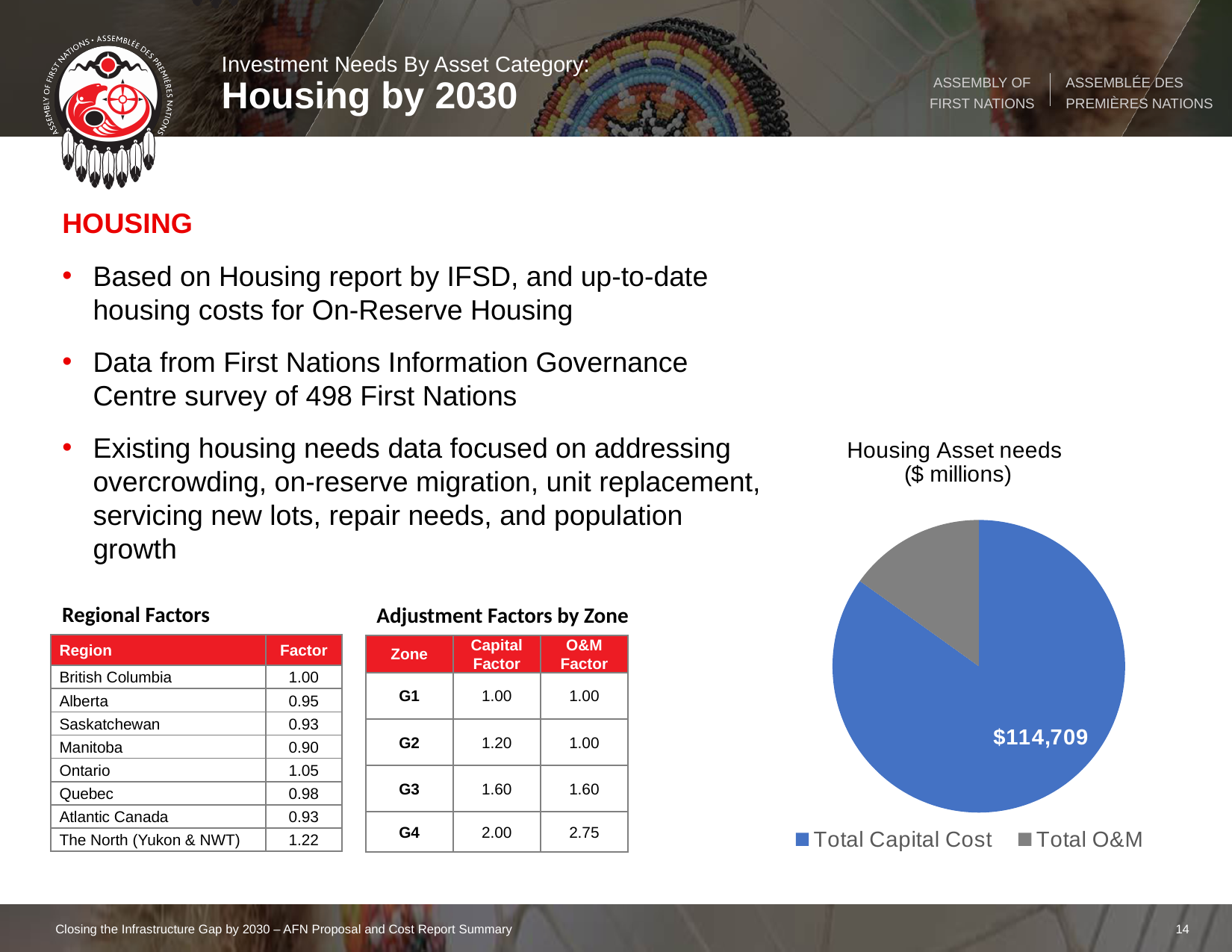
What is the title of the pie chart? Housing Asset needs ($ millions) In the pie chart, which is larger: Total Capital Cost or Total O&M? Total Capital Cost What kind of chart is shown on the slide? pie chart What value is labelled on the Total Capital Cost slice of the pie chart? $114,709 What colour is the Total O&M slice in the pie chart? grey Which slice of the pie chart is the smallest? Total O&M How many slices does the pie chart have? 2 Which slice of the pie chart is the largest? Total Capital Cost How many entries does the legend of the pie chart list? 2